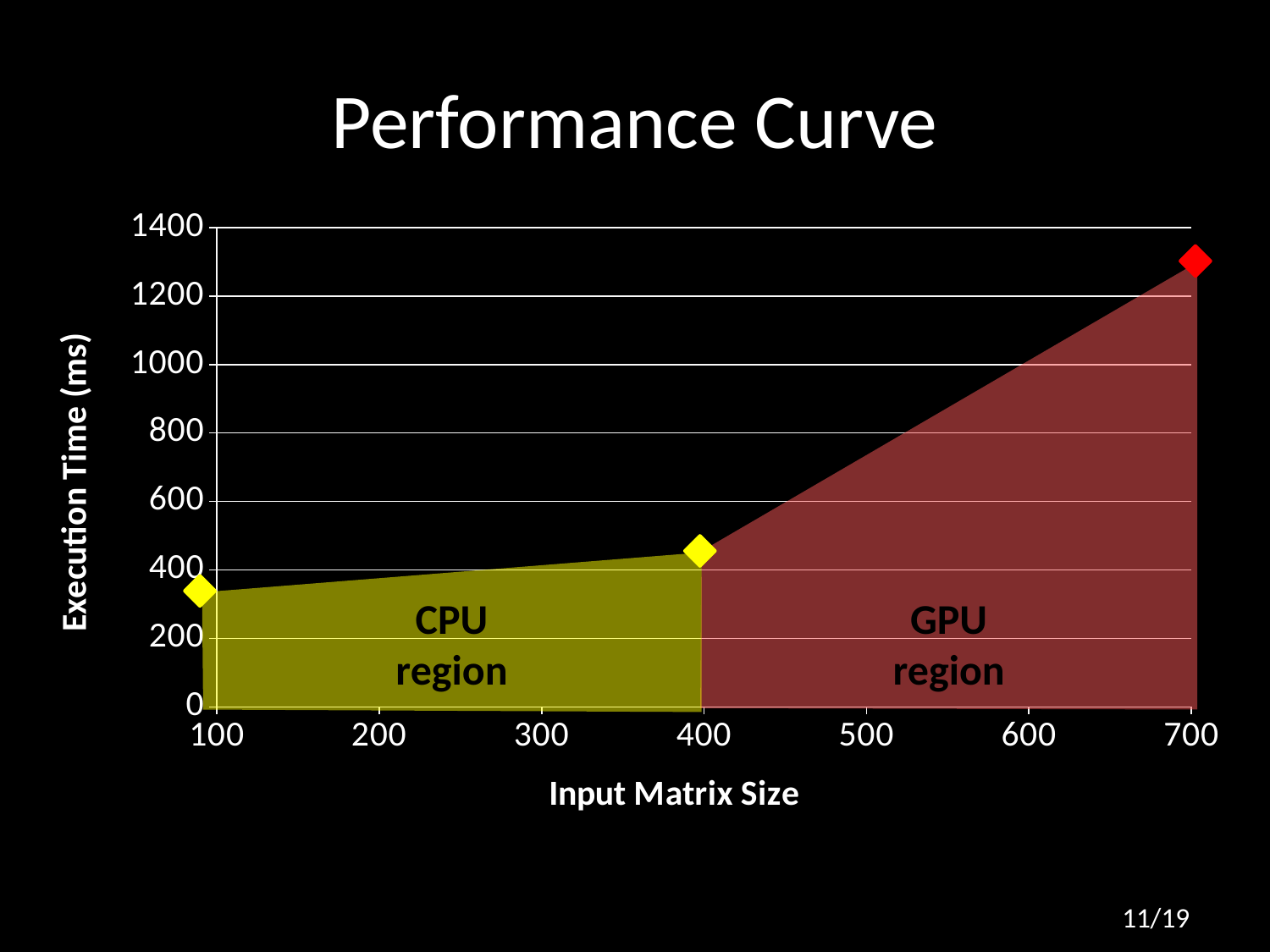
What is the label of the vertical axis? Execution Time (ms) Is the execution time at input matrix size 400 greater or less than 600? less What kind of chart is shown on the slide? area chart Which has the larger execution time, input matrix size 400 or 700? 700 At which input matrix size is the execution time highest? 700 Does the execution time rise or fall as the input matrix size increases? rise At which input matrix size is the execution time lowest? 100 Is the execution time at input matrix size 700 greater or less than 1200? greater Is the execution time at input matrix size 400 greater or less than 400? greater How many data points are marked on the curve? 3 What is the title of the chart? Performance Curve